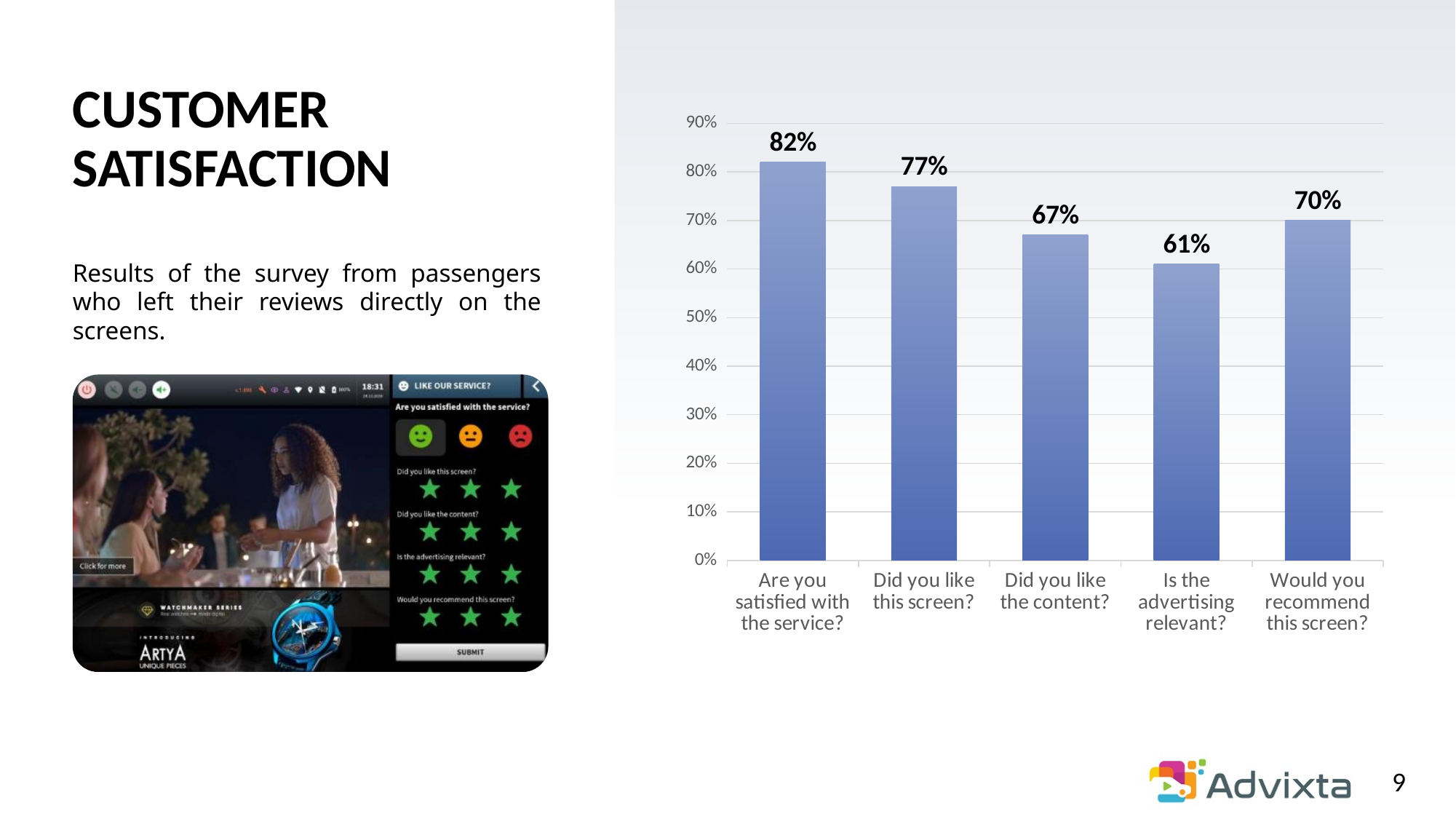
What is the value for "Are you satisfied with the service?"? 82% What is the value for "Would you recommend this screen?"? 70% What kind of chart is shown on the slide? bar chart What is the value for "Is the advertising relevant?"? 61% Which is larger: the value for "Did you like the content?" or the value for "Would you recommend this screen?"? Would you recommend this screen? What is the difference between the values for "Are you satisfied with the service?" and "Is the advertising relevant?"? 21% Which question has the lowest value? Is the advertising relevant? Is the value for "Did you like the content?" greater or less than 60%? greater What is the highest value shown on the vertical axis? 90% How many survey questions are shown on the chart? 5 What is the value for "Did you like this screen?"? 77% Which question has the highest value? Are you satisfied with the service?